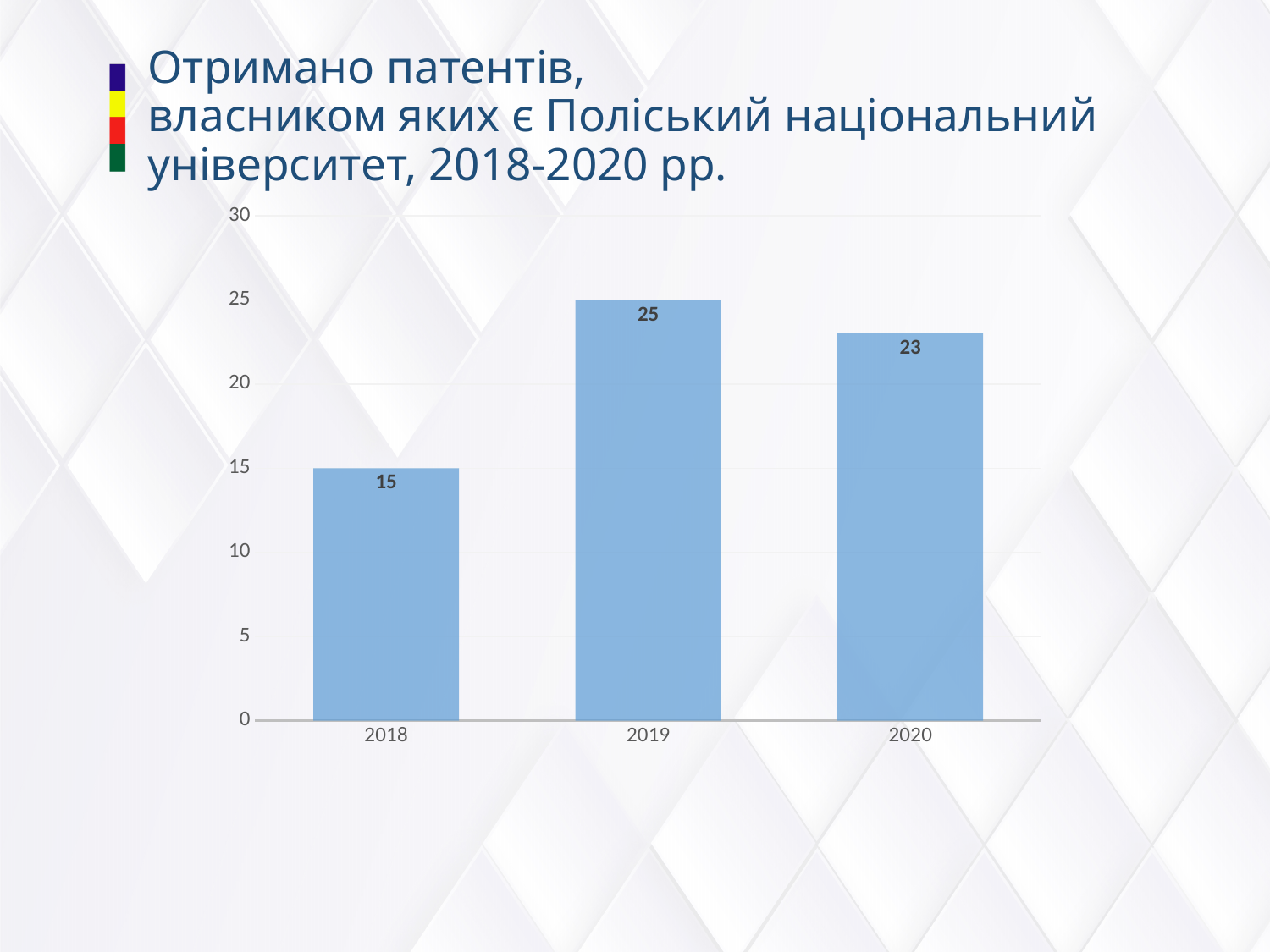
What kind of chart is shown on the slide? bar chart What is the value shown for 2020? 23 What is the difference between the values for 2019 and 2020? 2 Which is larger, the value for 2020 or the value for 2018? 2020 What is the value shown for 2019? 25 What is the difference between the values for 2019 and 2018? 10 Which year has the highest number of patents? 2019 How many patents were obtained in 2018? 15 How many years are shown on the x axis? 3 What is the highest value shown on the vertical axis? 30 Is the value for 2020 greater or less than 20? greater Which year has the lowest number of patents? 2018